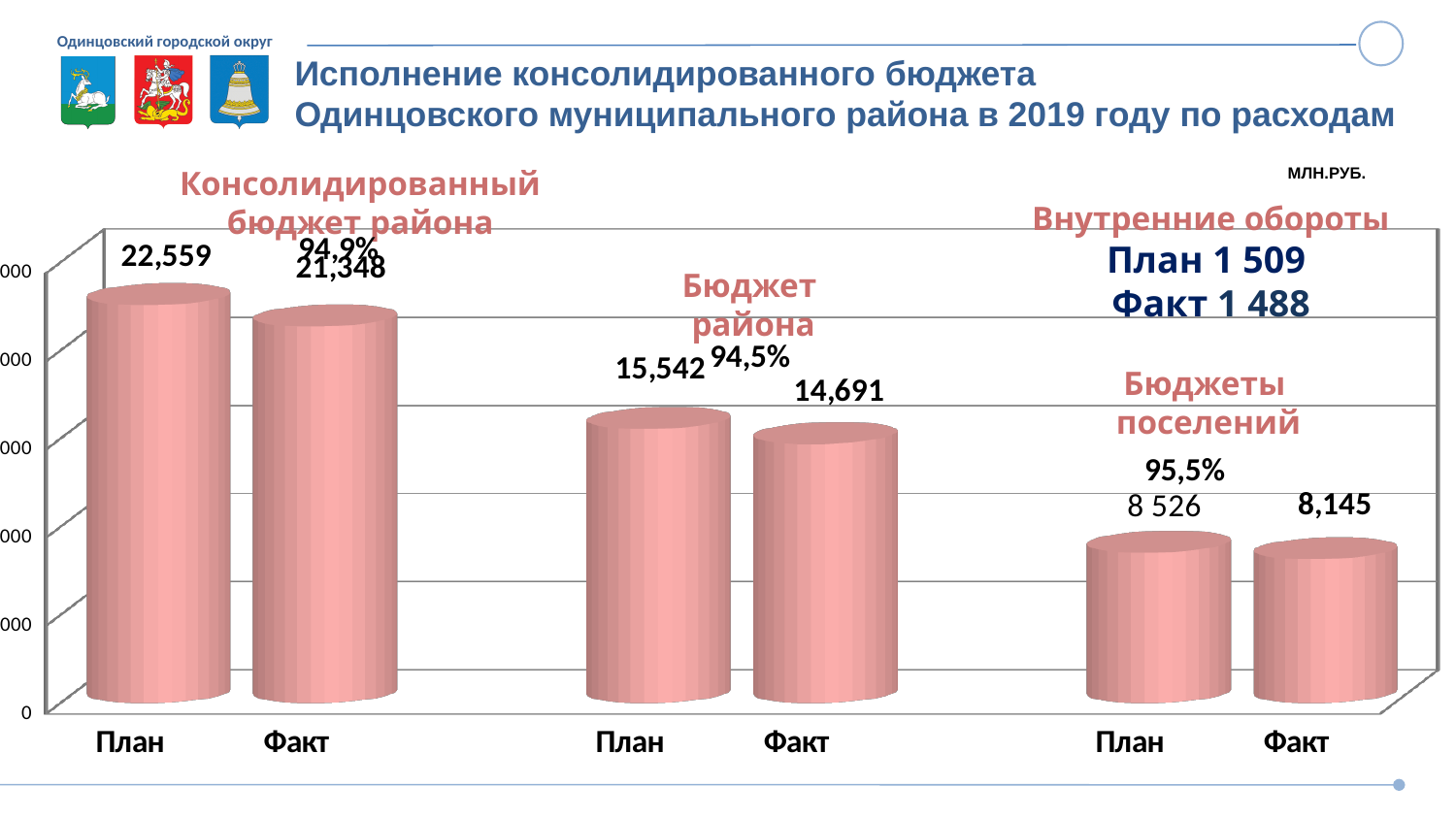
How many bars are plotted on the chart? 6 What is the value of the Факт bar for Бюджеты поселений? 8,145 What execution percentage is shown for Бюджет района? 94,5% Which bar has the lowest value on the chart? Факт for Бюджеты поселений (8,145) What is the difference between План and Факт for Консолидированный бюджет района? 1,211 What is the value of the План bar for Консолидированный бюджет района? 22,559 Which bar has the highest value on the chart? План for Консолидированный бюджет района (22,559) What is the difference between План and Факт for Бюджет района? 851 What kind of chart is shown on the slide? Bar chart Which is larger for Бюджеты поселений, План or Факт? План What is the value of the Факт bar for Консолидированный бюджет района? 21,348 What is the value of the План bar for Бюджет района? 15,542